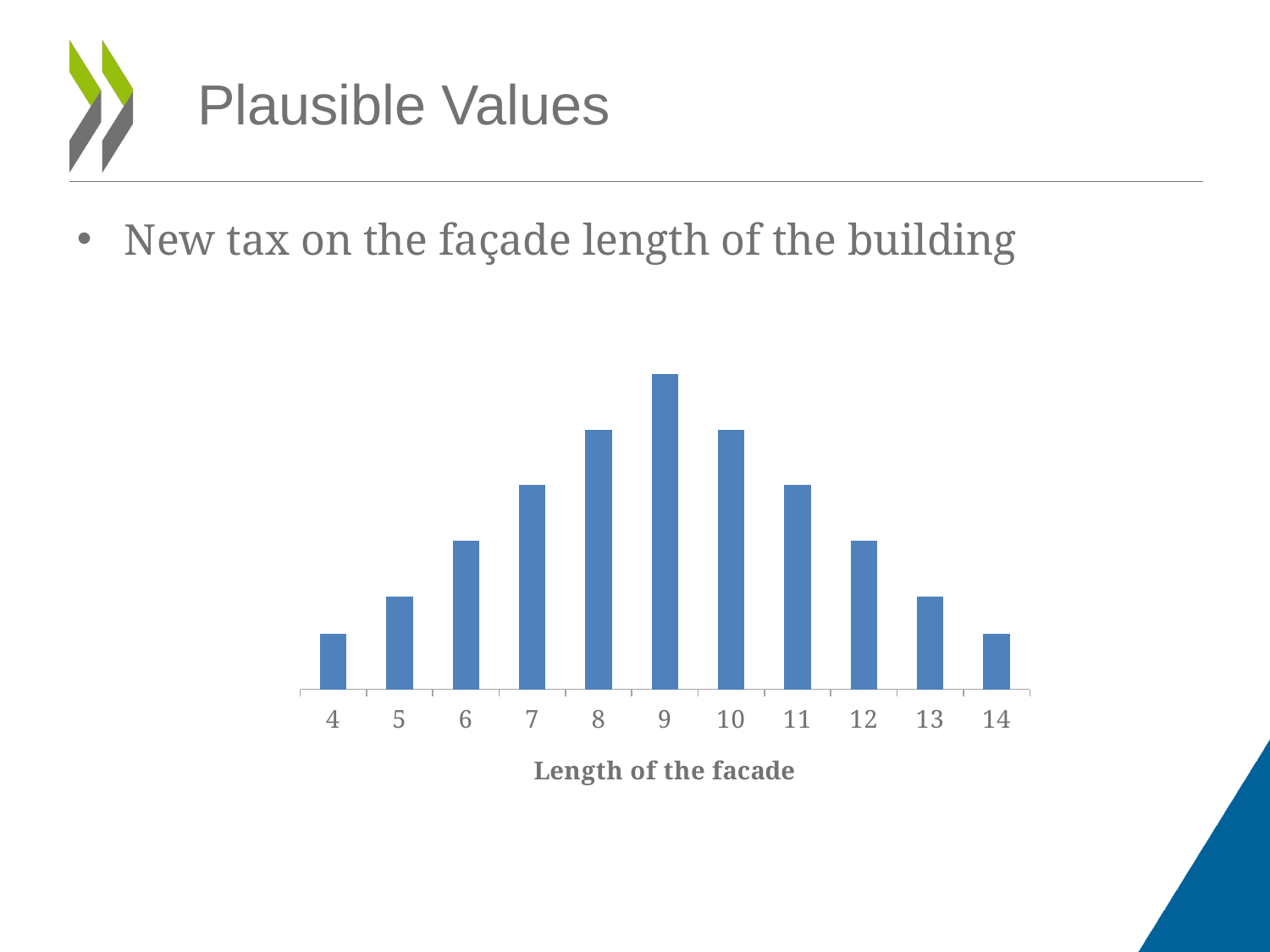
Which bar is taller, the one for facade length 5 or the one for facade length 8? 8 Which facade length has the tallest bar? 9 What kind of chart is shown on the slide? Bar chart How many facade length categories are shown on the x axis? 11 What colour are the bars in the chart? Blue What is the title of the x axis of the chart? Length of the facade Which bar is taller, the one for facade length 9 or the one for facade length 4? 9 Which bar is taller, the one for facade length 6 or the one for facade length 14? 6 How do the bar heights change as the facade length increases from 9 to 14? They fall How do the bar heights change as the facade length increases from 4 to 9? They rise